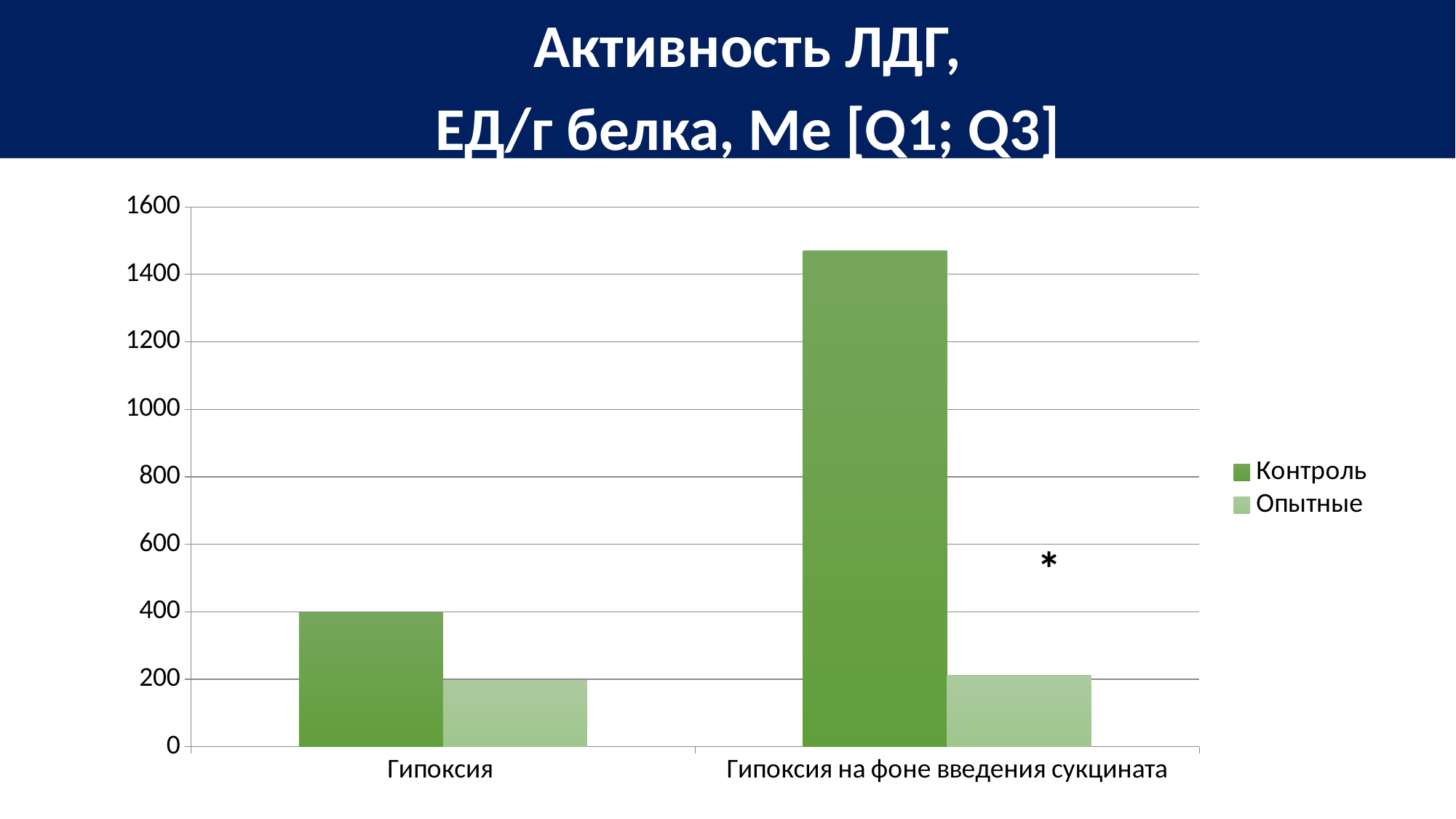
Is the value for Опытные in the Гипоксия на фоне введения сукцината category greater or less than 400? less Is the value for Контроль in the Гипоксия на фоне введения сукцината category greater or less than 1400? greater For the Контроль series, which category has the larger value? Гипоксия на фоне введения сукцината How many series does the legend list? 2 How many categories are shown on the x axis? 2 Which bar is the highest on the chart? Контроль in Гипоксия на фоне введения сукцината What kind of chart is shown on the slide? Bar chart In the Гипоксия category, which series has the larger value, Контроль or Опытные? Контроль What are the two entries listed in the legend? Контроль and Опытные